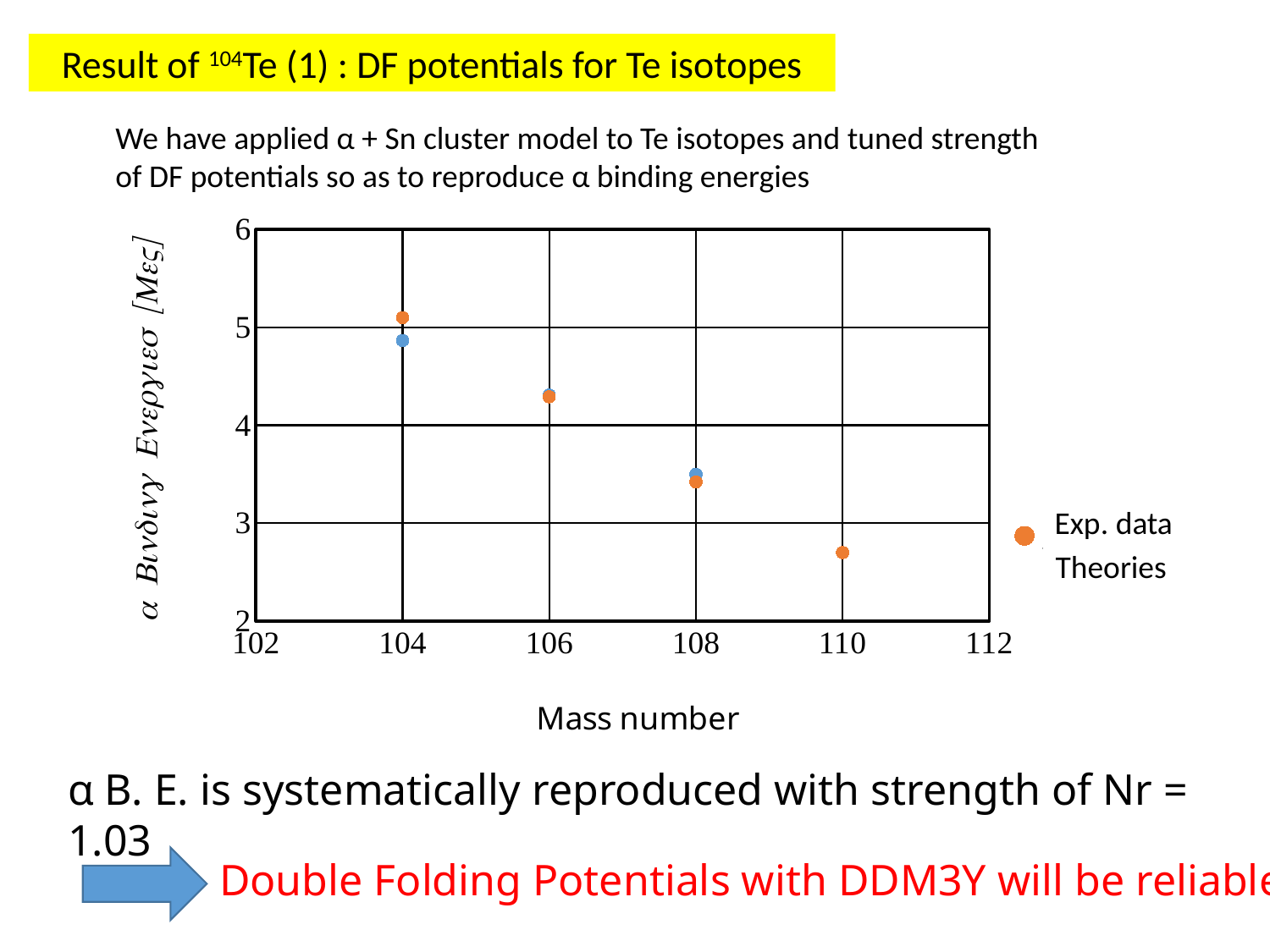
Is the Exp. data value at mass number 104 greater or less than 5? greater Is the Exp. data value at mass number 106 greater or less than 4? greater What kind of chart is shown on the slide? scatter chart At which mass number is the Exp. data alpha binding energy highest? 104 Is the Exp. data value at mass number 110 greater or less than 3? less Do the alpha binding energies rise or fall as the mass number increases? fall At which mass number is the Exp. data alpha binding energy lowest? 110 How many mass numbers have data points plotted in the chart? 4 What is the title of the x axis? Mass number How many series does the legend list? 2